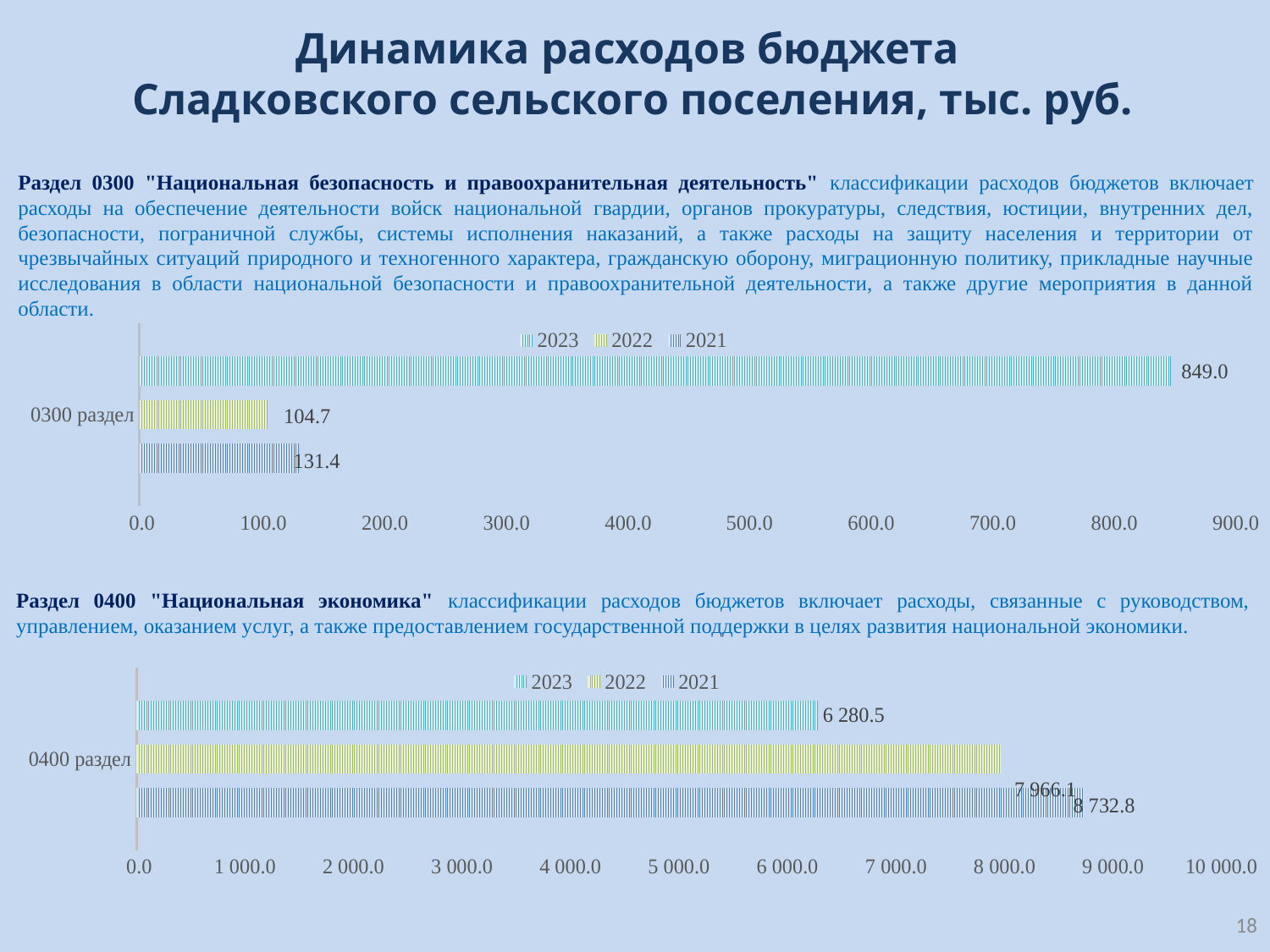
In the bottom chart (0400 раздел), what is the value for 2021? 8 732.8 In the top chart (0300 раздел), what is the value for 2022? 104.7 In the top chart (0300 раздел), what is the value for 2023? 849.0 In the bottom chart (0400 раздел), what is the value for 2023? 6 280.5 In the top chart (0300 раздел), what is the difference between the 2023 and 2021 values? 717.6 In the top chart (0300 раздел), which year has the highest value? 2023 How many series does the legend of the bottom chart (0400 раздел) list? 3 In the bottom chart (0400 раздел), which year has the highest value? 2021 In the top chart (0300 раздел), which year has the lowest value? 2022 In the top chart (0300 раздел), what is the value for 2021? 131.4 What type of chart is the top chart (0300 раздел)? Bar chart In the bottom chart (0400 раздел), which is larger, the value for 2022 or the value for 2023? 2022